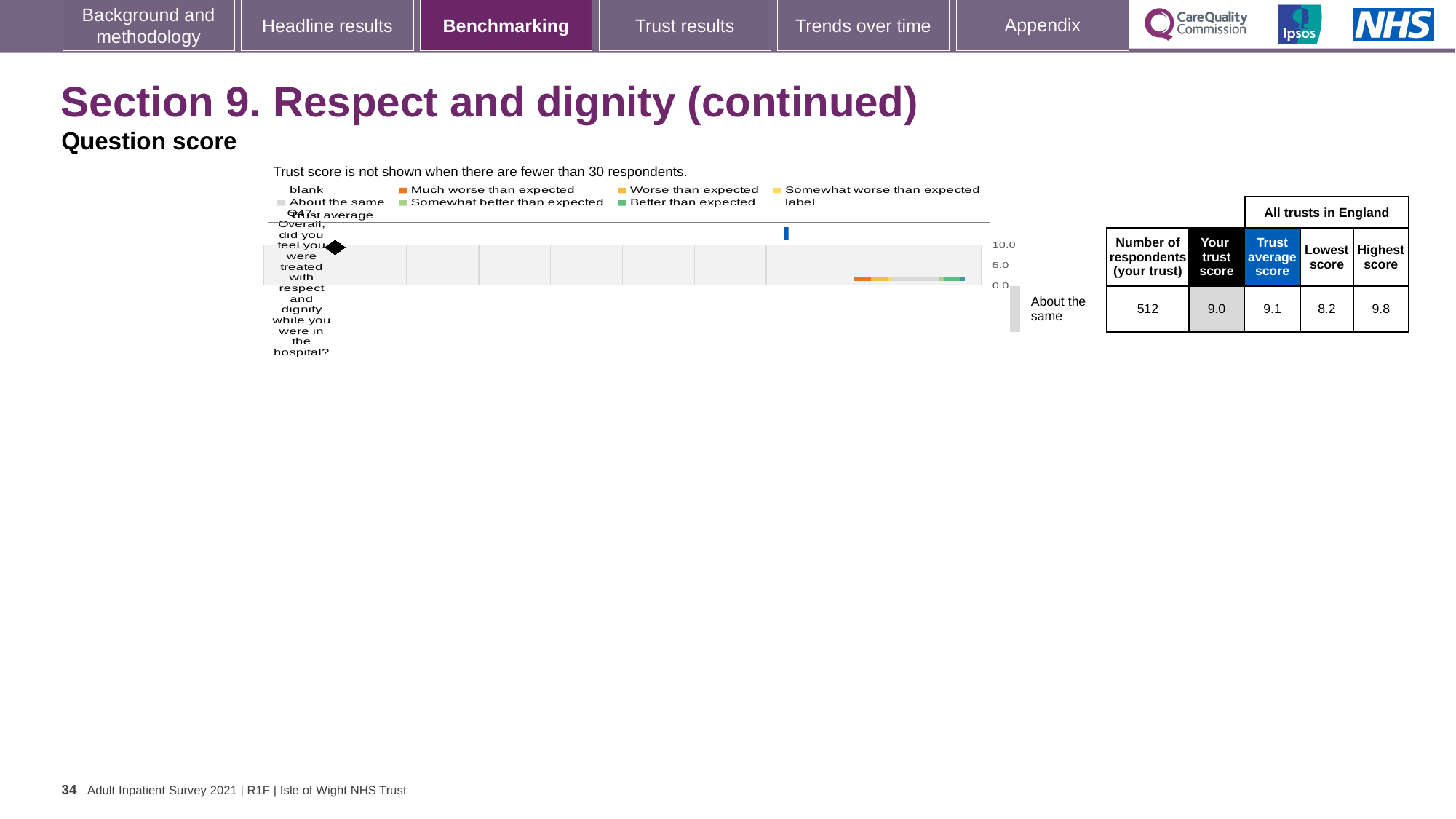
Which is larger for Q47: the trust score or the trust average score? Trust average score What is the highest score among all trusts in England for Q47? 9.8 What is the highest value shown on the chart's score axis? 10.0 What is the difference between the trust average score and the trust score for Q47? 0.1 What kind of chart is shown on the slide? Bar chart What is the difference between the highest score and the lowest score for Q47 across all trusts in England? 1.6 What is the lowest score among all trusts in England for Q47? 8.2 How many respondents from the trust answered Q47? 512 How is the trust's result for Q47 categorised relative to expectations? About the same How many survey questions are plotted on the chart? 1 What is the trust score for Q47 shown on the slide? 9.0 What is the trust average score for Q47 across all trusts in England? 9.1